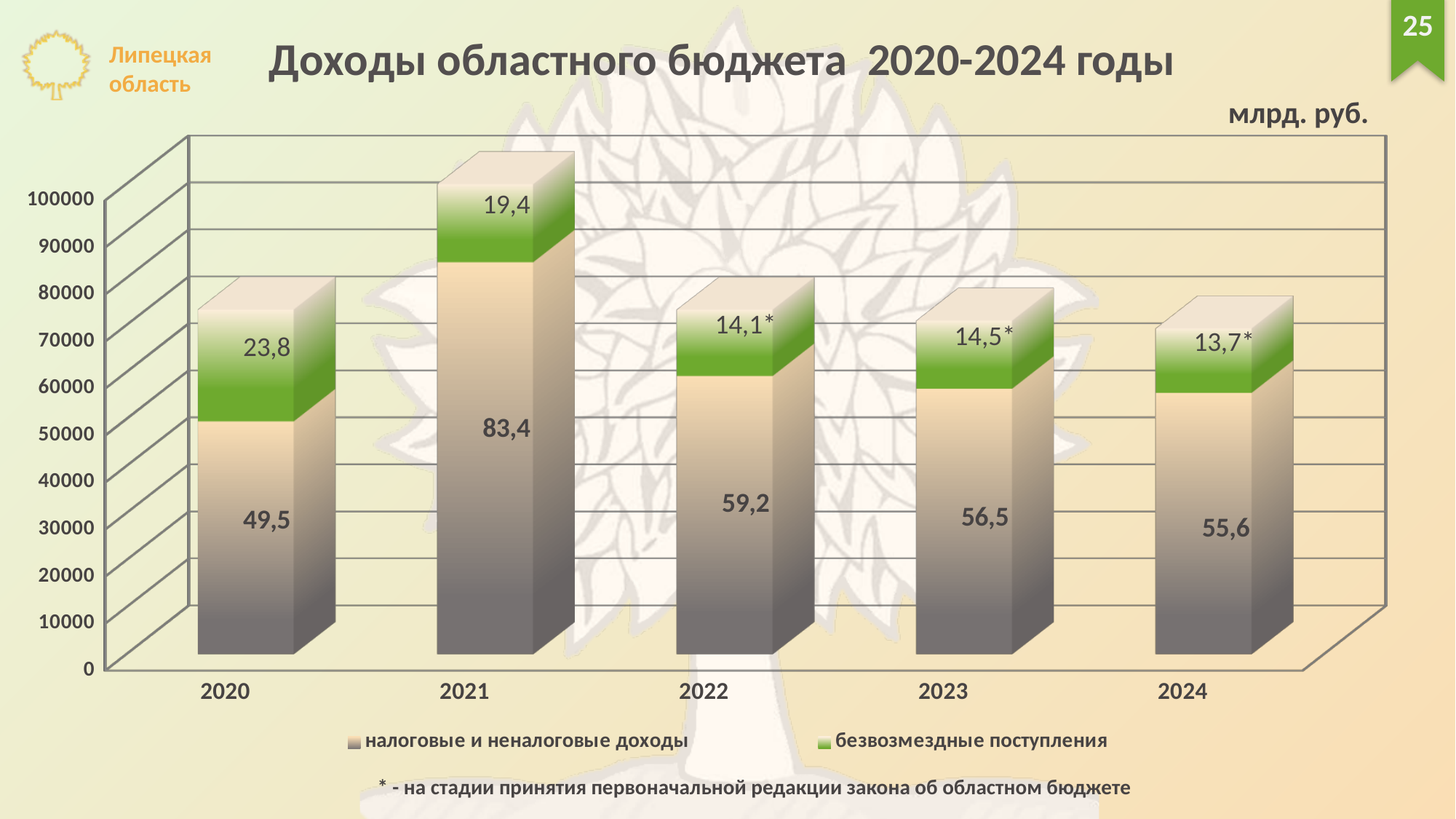
Which year has the highest value of налоговые и неналоговые доходы? 2021 What is the value of безвозмездные поступления for 2020? 23,8 What is the value of налоговые и неналоговые доходы for 2024? 55,6 How many years are shown on the x axis? 5 What kind of chart is shown on the slide? Stacked bar chart Which is larger: безвозмездные поступления in 2020 or in 2021? 2020 What is the value of налоговые и неналоговые доходы for 2021? 83,4 What is the difference between налоговые и неналоговые доходы in 2021 and in 2020? 33,9 How many series does the legend list? 2 Which year has the lowest value of безвозмездные поступления? 2024 Do the values of налоговые и неналоговые доходы rise or fall from 2021 to 2024? Fall What is the total of the stacked bar for 2020? 73,3